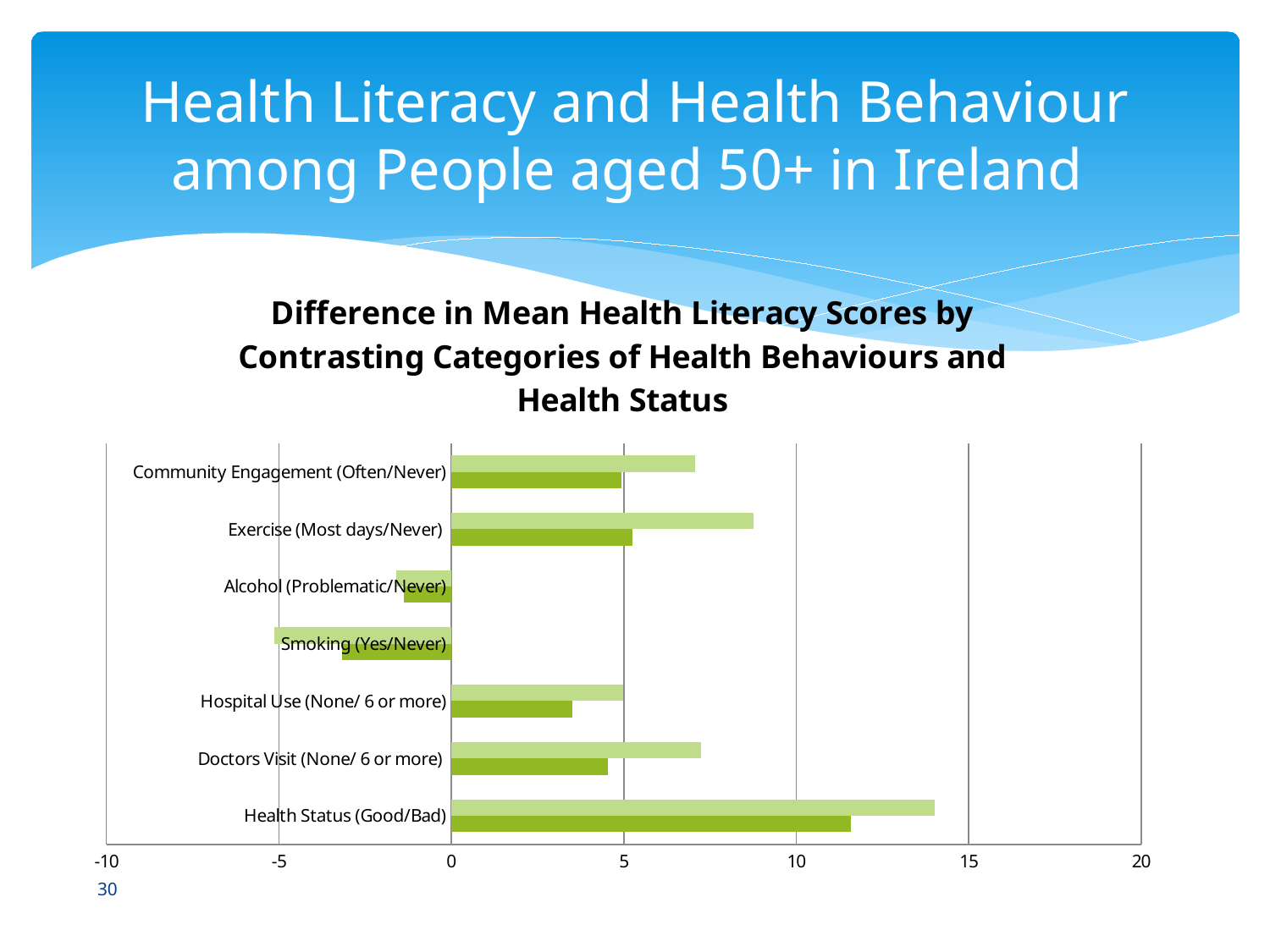
Is the darker green bar for Smoking (Yes/Never) greater or less than -5? greater What kind of chart is shown on the slide? bar chart How many categories are listed on the vertical axis of the chart? 7 Which has the larger lighter green bar: Exercise (Most days/Never) or Community Engagement (Often/Never)? Exercise (Most days/Never) Which category has the most negative (lowest) values in the chart? Smoking (Yes/Never) Is the lighter green bar for Health Status (Good/Bad) greater or less than 10? greater Is the darker green bar for Hospital Use (None/ 6 or more) greater or less than 5? less Which has the larger lighter green bar: Doctors Visit (None/ 6 or more) or Hospital Use (None/ 6 or more)? Doctors Visit (None/ 6 or more) How many categories have bars extending to the left of zero (negative values)? 2 Which category has the longest bars in the chart? Health Status (Good/Bad) What is the title of the chart? Difference in Mean Health Literacy Scores by Contrasting Categories of Health Behaviours and Health Status